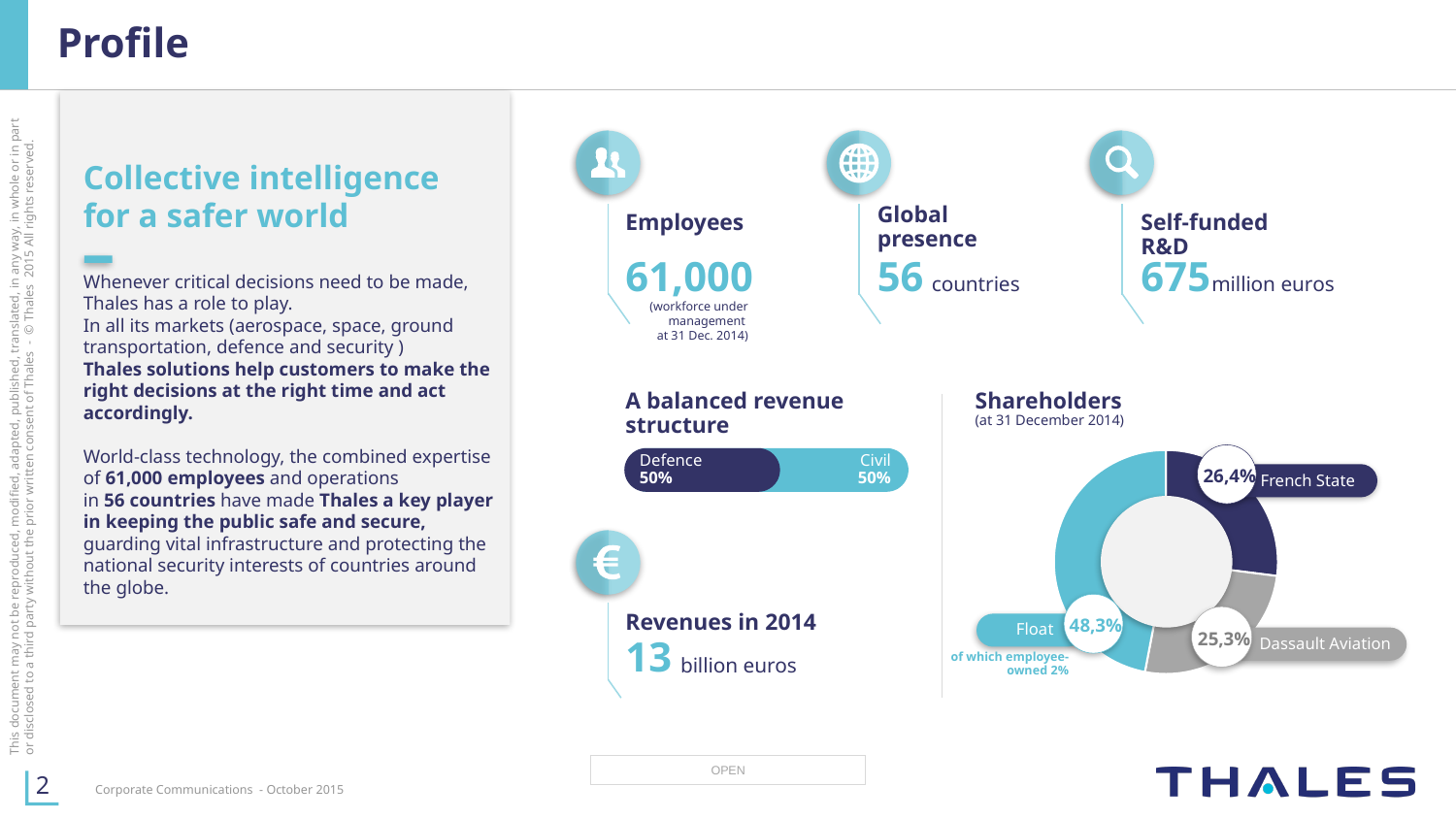
How many shareholder categories are shown in the Shareholders chart? 3 In the 'A balanced revenue structure' bar, what share is Defence? 50% In the Shareholders chart, how many percentage points larger is the Float share than the French State share? 21,9% In the Shareholders chart, which shareholder category has the smallest share? Dassault Aviation In the Shareholders chart, what share is held by Dassault Aviation? 25,3% In the Shareholders chart, what date is the data stated as of? 31 December 2014 In the 'A balanced revenue structure' bar, what share is Civil? 50% In the Shareholders chart, what share is held by the French State? 26,4% In the Shareholders chart, what share is the Float? 48,3% In the Shareholders chart, which shareholder category has the largest share? Float In the Shareholders chart, which is larger: the French State share or the Dassault Aviation share? French State What kind of chart is the Shareholders chart? Donut (pie) chart